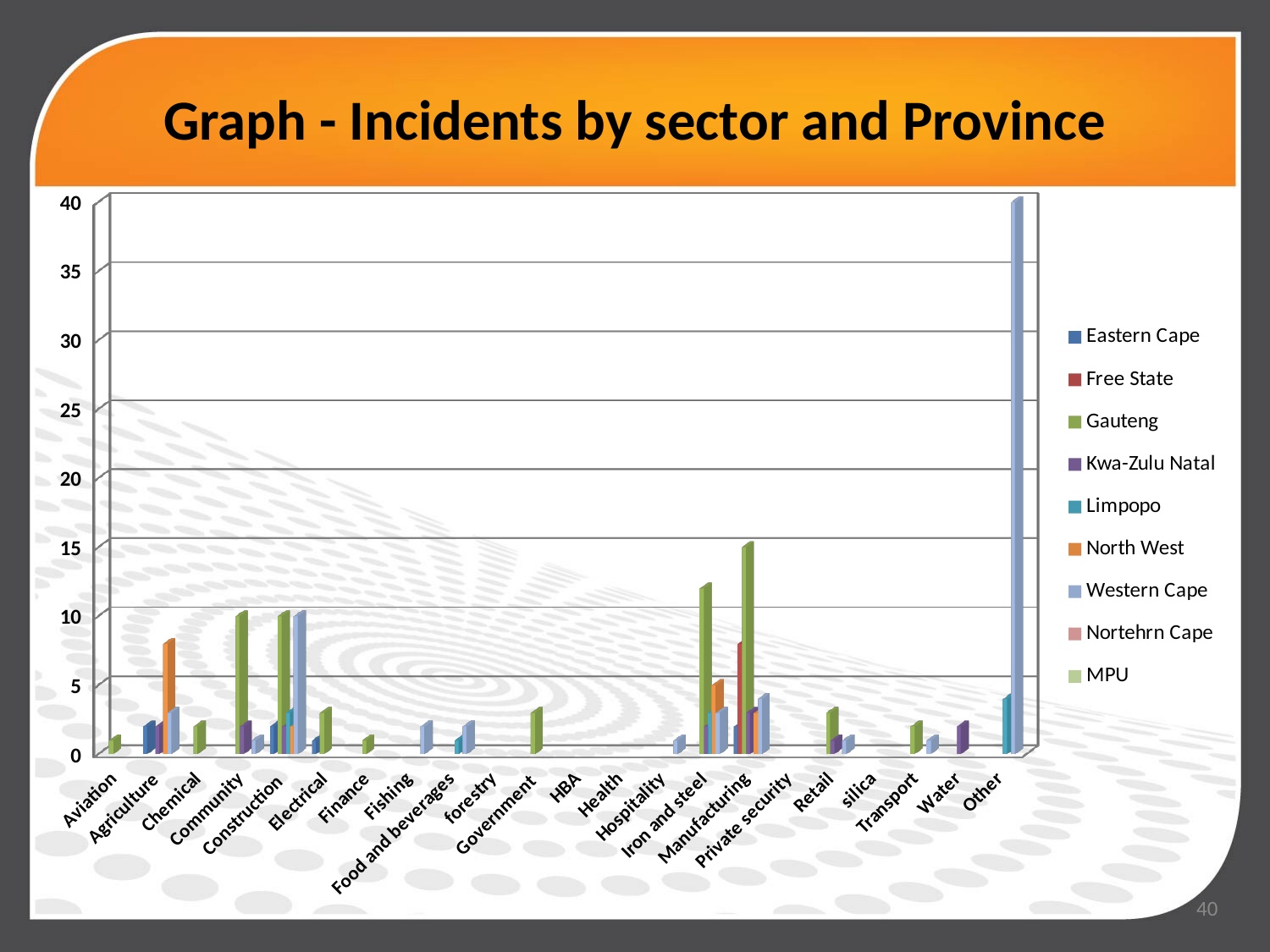
Is the Gauteng value for Government greater or less than 5? less Which is larger for Gauteng: the value for Manufacturing or the value for Iron and steel? Manufacturing Is the Western Cape value for Other greater or less than 35? greater How many series does the legend list? 9 What kind of chart is shown on the slide? Bar chart Which sector category contains the tallest bar in the chart? Other Is the Gauteng value for Iron and steel greater or less than 10? greater How many sector categories are shown along the x axis? 22 What is the title of the chart on the slide? Graph - Incidents by sector and Province